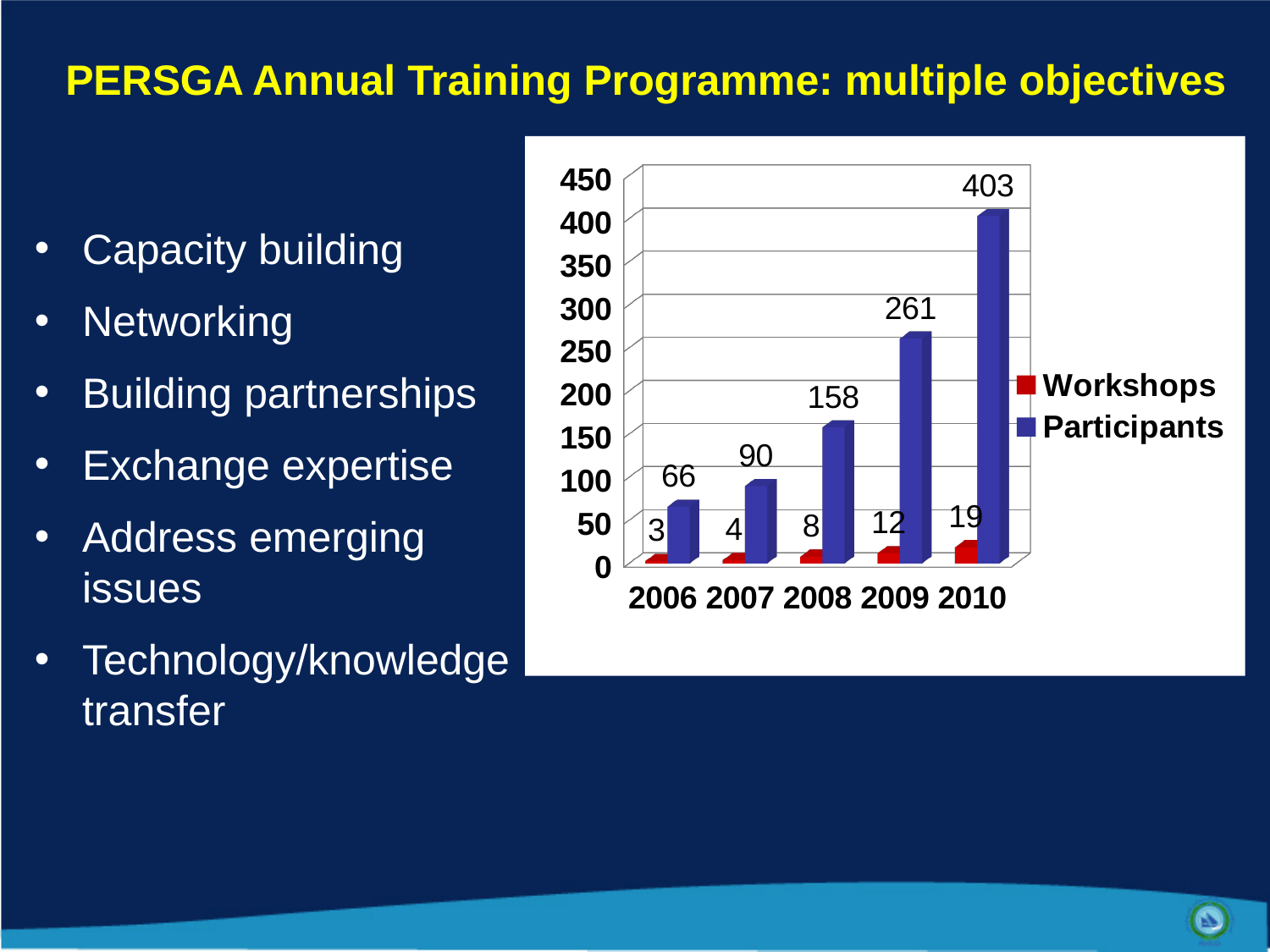
What is the difference in Participants between 2010 and 2009? 142 How many Participants were there in 2010? 403 How many Workshops were held in 2008? 8 How many years are shown on the x axis of the chart? 5 What is the difference in Workshops between 2010 and 2006? 16 How many series does the chart legend list? 2 Which year had the lowest number of Workshops? 2006 Which is larger, the number of Participants in 2008 or in 2009? 2009 Which year had the highest number of Participants? 2010 What kind of chart is shown on the slide? Bar chart Do the Participants values rise or fall from 2006 to 2010? Rise How many Participants were there in 2007? 90